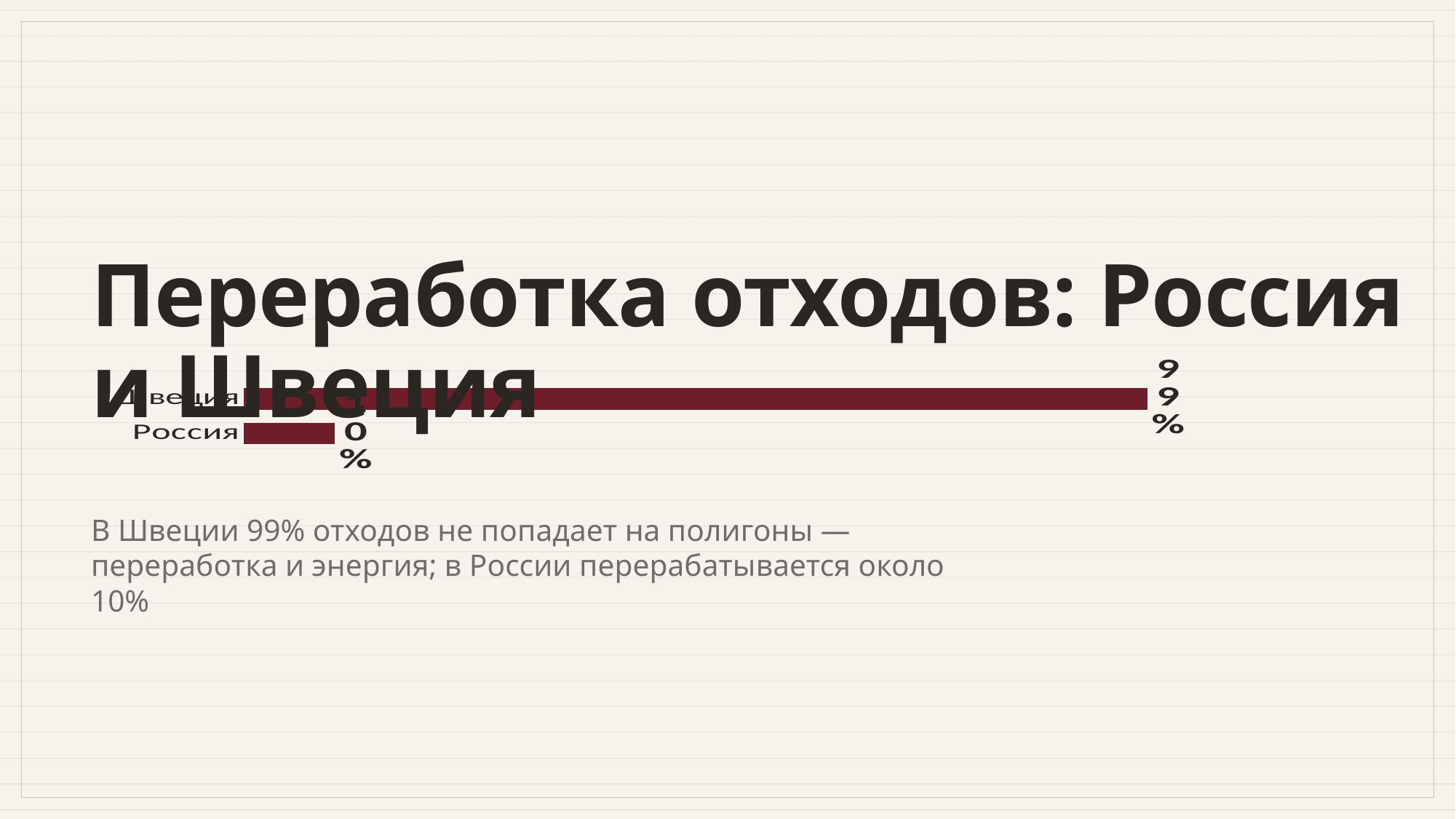
What kind of chart is shown on the slide? Bar chart Which category has the highest value in the bar chart? Швеция What is the value shown for Швеция in the bar chart? 99% Which category has the lowest value in the bar chart? Россия How many categories are shown in the bar chart? 2 Which category is listed at the top of the bar chart? Швеция Are the bars in the chart drawn horizontally or vertically? Horizontally Which has the larger value in the bar chart, Швеция or Россия? Швеция